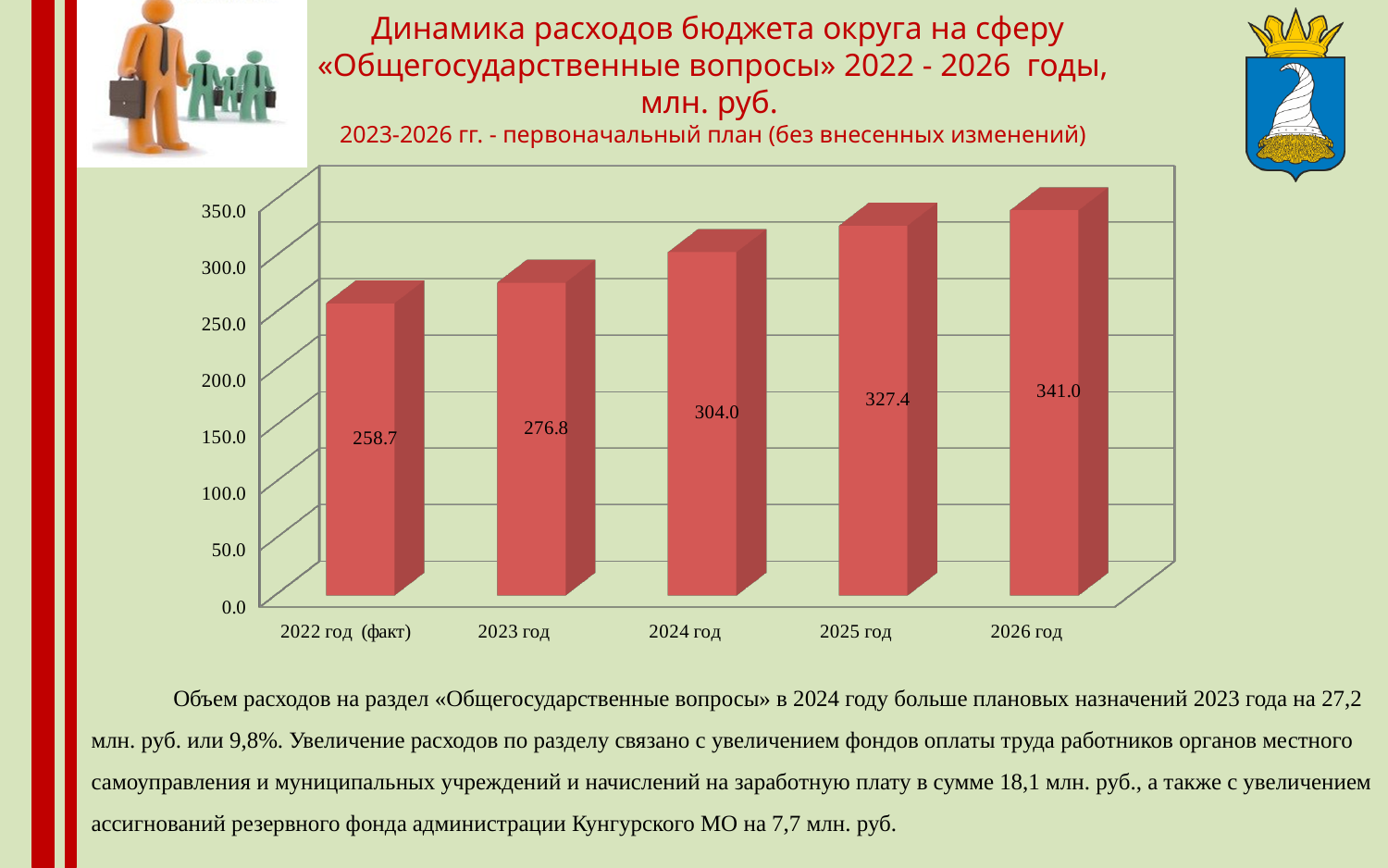
What is the value for 2024 год? 304.0 What kind of chart is shown on the slide? bar chart What is the difference between the values for 2024 год and 2023 год? 27.2 Is the value for 2025 год greater or less than 300.0? greater Which is larger, the value for 2025 год or the value for 2023 год? 2025 год Which year has the lowest value? 2022 год (факт) What is the value for 2026 год? 341.0 How many years are shown on the chart? 5 What is the value for 2022 год (факт)? 258.7 Do the values rise or fall from 2022 to 2026? rise Which year has the highest value? 2026 год What is the difference between the values for 2026 год and 2025 год? 13.6